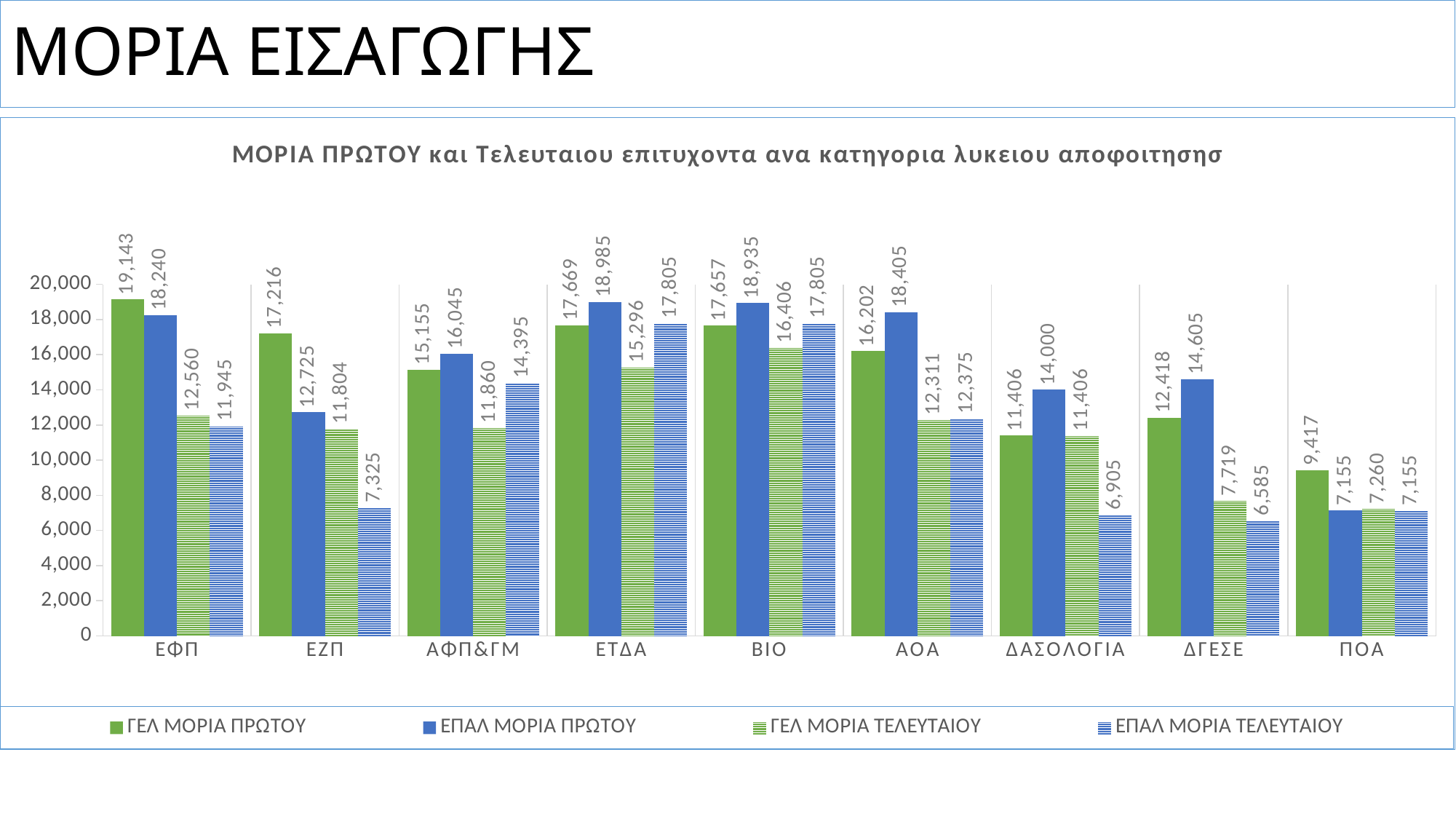
What kind of chart is shown on the slide? Bar chart What is the difference between ΓΕΛ ΜΟΡΙΑ ΠΡΩΤΟΥ and ΕΠΑΛ ΜΟΡΙΑ ΠΡΩΤΟΥ for ΕΦΠ? 903 How many categories are shown on the x axis? 9 How many series does the legend list? 4 Which category has the highest ΓΕΛ ΜΟΡΙΑ ΠΡΩΤΟΥ value? ΕΦΠ Which category has the lowest ΕΠΑΛ ΜΟΡΙΑ ΤΕΛΕΥΤΑΙΟΥ value? ΔΓΕΣΕ What is the title of the chart? ΜΟΡΙΑ ΠΡΩΤΟΥ και Τελευταιου επιτυχοντα ανα κατηγορια λυκειου αποφοιτησησ What is the value of ΕΠΑΛ ΜΟΡΙΑ ΤΕΛΕΥΤΑΙΟΥ for ΕΖΠ? 7,325 What is the value of ΓΕΛ ΜΟΡΙΑ ΠΡΩΤΟΥ for ΕΦΠ? 19,143 What is the value of ΕΠΑΛ ΜΟΡΙΑ ΠΡΩΤΟΥ for ΔΑΣΟΛΟΓΙΑ? 14,000 What is the difference between ΓΕΛ ΜΟΡΙΑ ΤΕΛΕΥΤΑΙΟΥ and ΕΠΑΛ ΜΟΡΙΑ ΤΕΛΕΥΤΑΙΟΥ for ΔΓΕΣΕ? 1,134 For ΑΟΑ, which is larger: ΓΕΛ ΜΟΡΙΑ ΠΡΩΤΟΥ or ΕΠΑΛ ΜΟΡΙΑ ΠΡΩΤΟΥ? ΕΠΑΛ ΜΟΡΙΑ ΠΡΩΤΟΥ